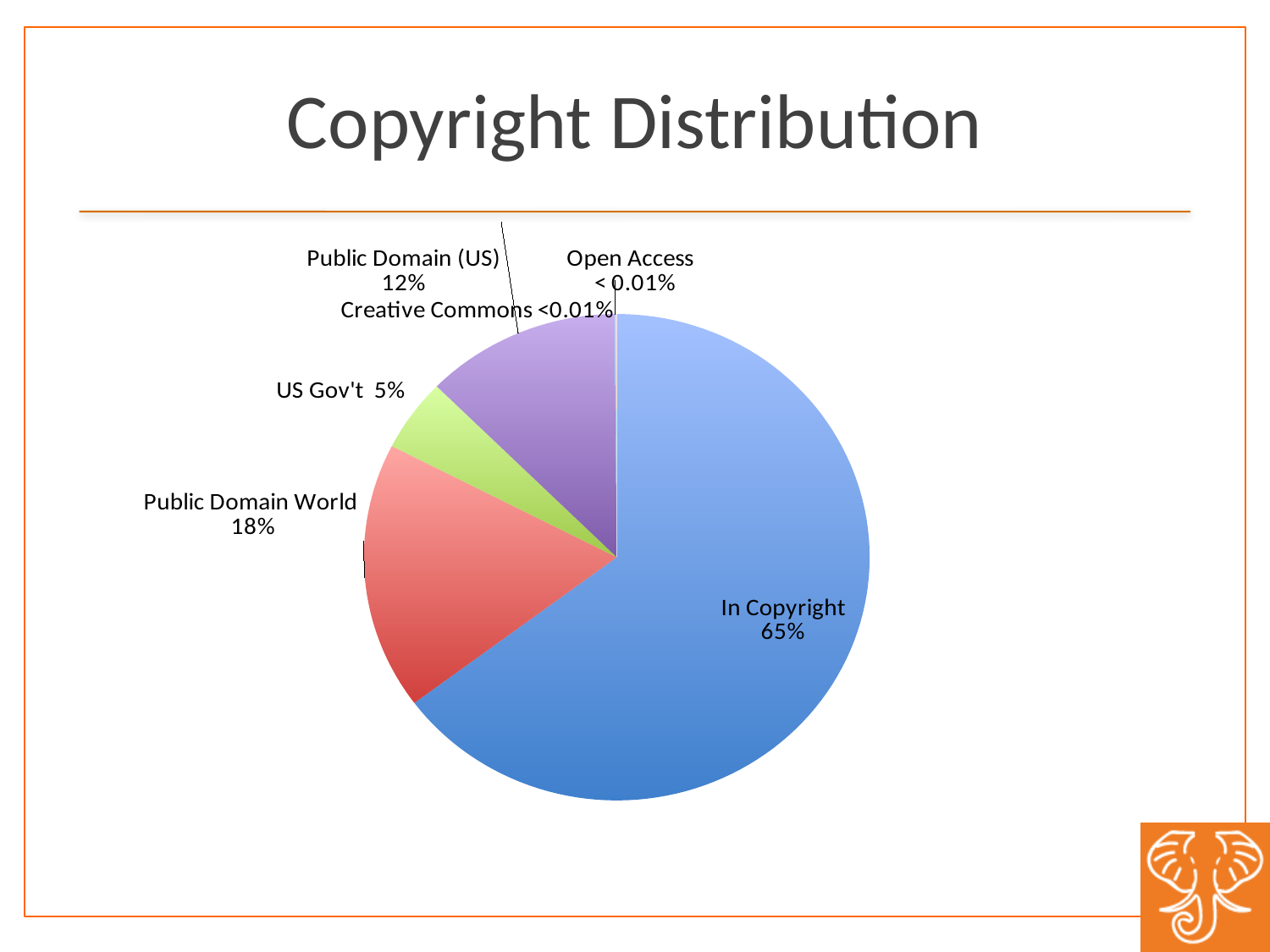
How many categories are labelled on the pie chart? 6 Which category has the largest slice of the pie? In Copyright What share of the pie is labelled for Creative Commons? <0.01% What share of the pie is In Copyright? 65% What share of the pie is Public Domain World? 18% What share of the pie is US Gov't? 5% Which is larger, Public Domain World or Public Domain (US)? Public Domain World What is the title of the chart? Copyright Distribution What type of chart is shown on the slide? pie chart What share of the pie is labelled for Open Access? < 0.01% What is the difference in percentage points between In Copyright and Public Domain World? 47